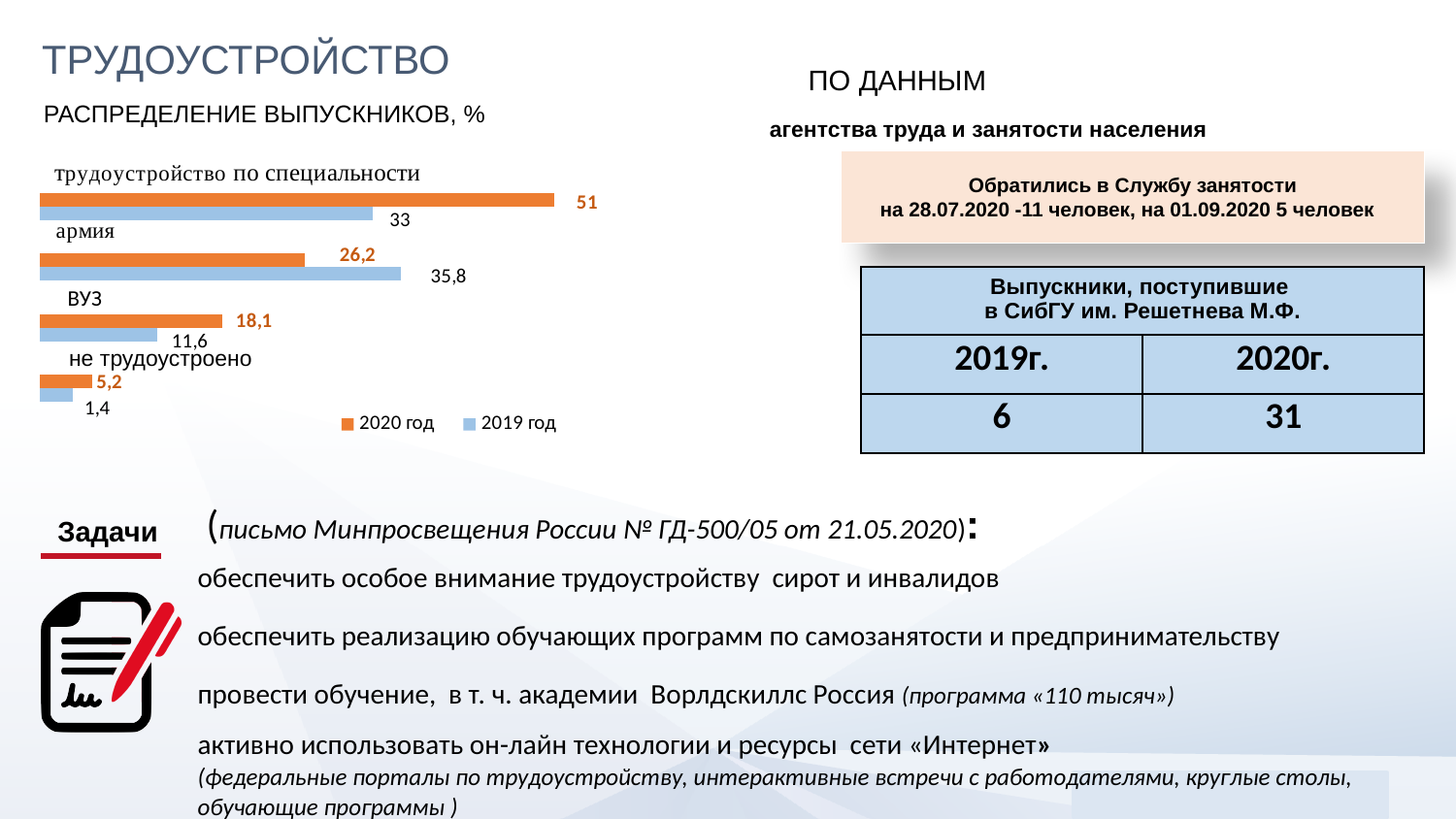
How many categories are shown in the bar chart? 4 What is the difference between the 2020 год and 2019 год values for 'трудоустройство по специальности'? 18 What is the value for 'не трудоустроено' in the 2019 год series? 1,4 How many series does the chart legend list? 2 What is the value for 'армия' in the 2019 год series? 35,8 What is the value for 'трудоустройство по специальности' in the 2020 год series? 51 Which category has the highest value in the 2020 год series? трудоустройство по специальности What is the value for 'ВУЗ' in the 2020 год series? 18,1 Which colour represents the 2020 год series in the chart? orange What type of chart is used to show the distribution of graduates? bar chart For 'армия', which series has the larger value, 2020 год or 2019 год? 2019 год Which category has the lowest value in the 2019 год series? не трудоустроено